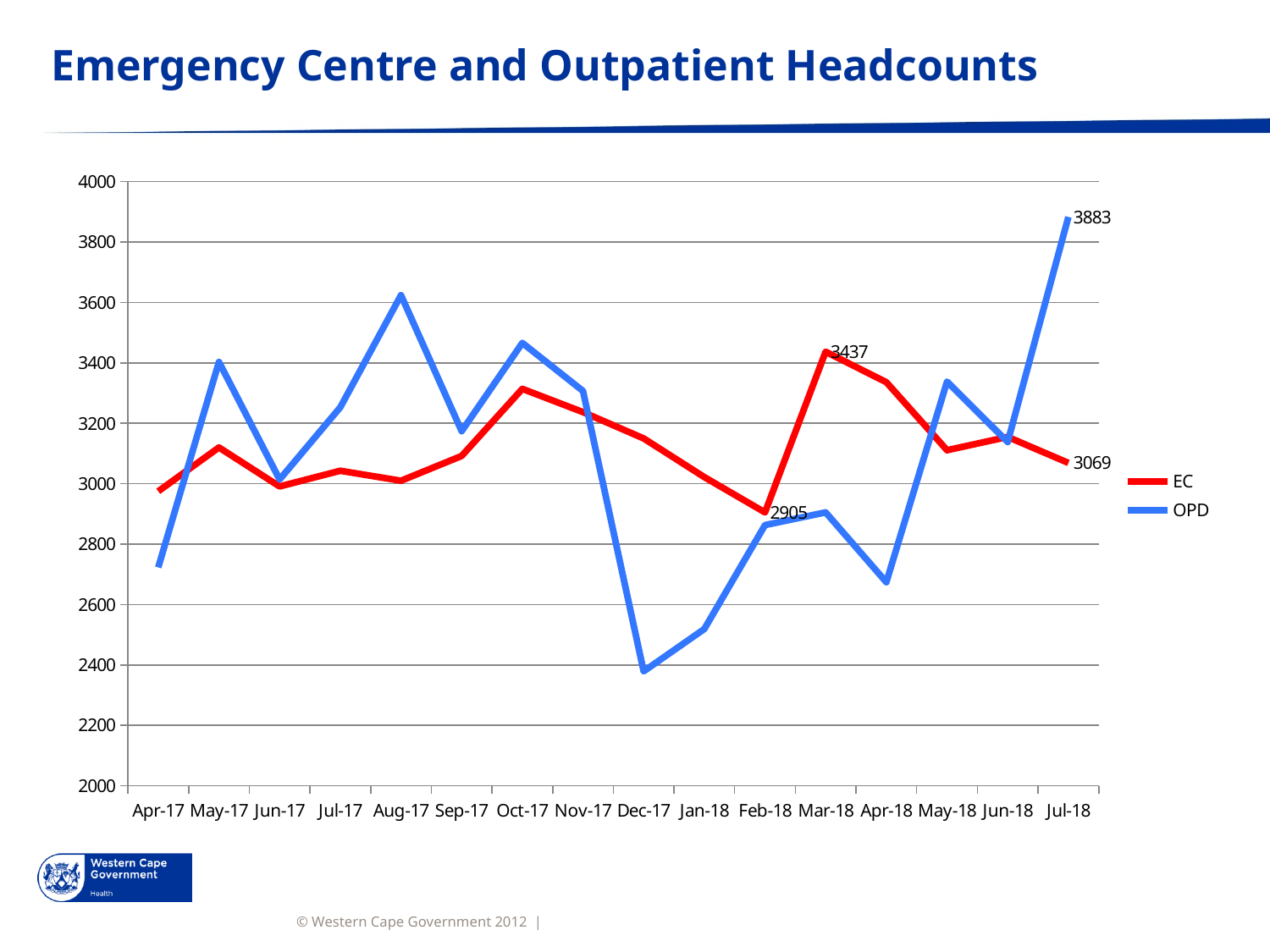
How many months are shown on the x axis? 16 In which month does the OPD series reach its lowest value? Dec-17 What is the EC value for Feb-18? 2905 Is the OPD value for Aug-17 greater or less than 3400? greater In Jul-18, how much higher is the OPD value than the EC value? 814 What type of chart is shown on the slide? Line chart What is the EC value for Mar-18? 3437 What is the EC value for Jul-18? 3069 In Dec-17, which series has the larger value, EC or OPD? EC In which month does the OPD series reach its highest value? Jul-18 What is the OPD value for Jul-18? 3883 What is the difference between the EC values for Mar-18 and Feb-18? 532